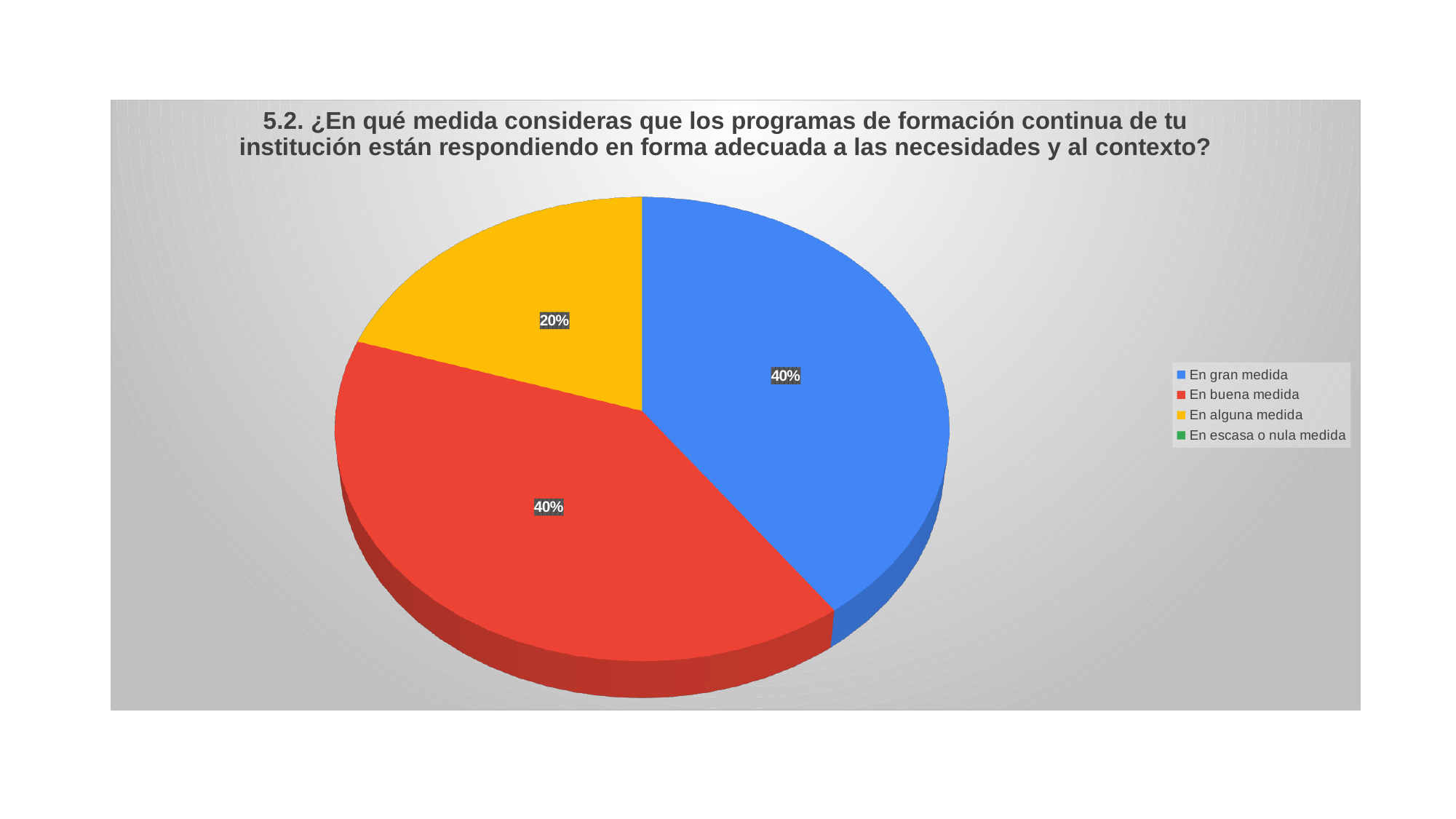
Which legend entry is shown in green? En escasa o nula medida What percentage is shown for the 'En alguna medida' slice? 20% What percentage is shown for the 'En gran medida' slice? 40% How many entries does the legend list? 4 What is the difference in percentage points between the 'En buena medida' slice and the 'En alguna medida' slice? 20 percentage points What percentage is shown for the 'En buena medida' slice? 40% How many slices with a printed percentage are visible in the pie? 3 What kind of chart is shown on the slide? pie chart What colour is the 'En buena medida' slice? red Which is larger, the 'En gran medida' slice or the 'En alguna medida' slice? En gran medida Which is larger, the 'En buena medida' slice or the 'En alguna medida' slice? En buena medida What share of the pie does the 'En alguna medida' slice represent? 20%